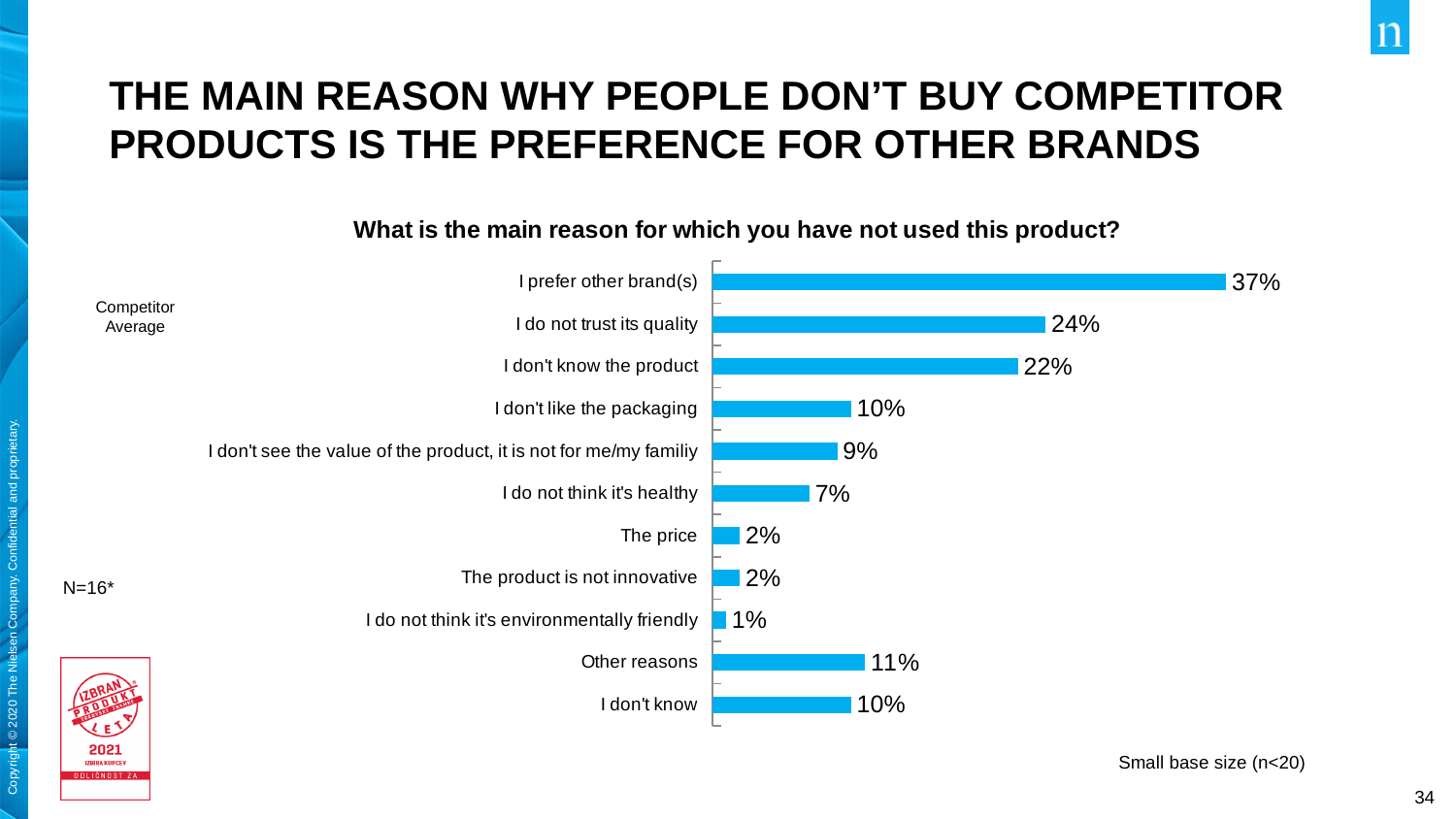
What type of chart is used on this slide? Bar chart What percentage is shown for "Other reasons"? 11% What is the sample size (N) noted on the slide for this chart? N=16* How many reason categories are plotted in the chart? 11 Which reason has the highest percentage in the chart? I prefer other brand(s) What is the difference between "Other reasons" and "I don't know"? 1% What percentage of respondents said "I prefer other brand(s)" as the main reason for not using the product? 37% What is the value shown for "I do not trust its quality"? 24% What question is the chart based on, as shown in the chart title? What is the main reason for which you have not used this product? What is the difference in percentage points between "I prefer other brand(s)" and "I do not trust its quality"? 13 Which is larger: the value for "I don't know the product" or the value for "I don't like the packaging"? I don't know the product Which reason has the lowest percentage in the chart? I do not think it's environmentally friendly